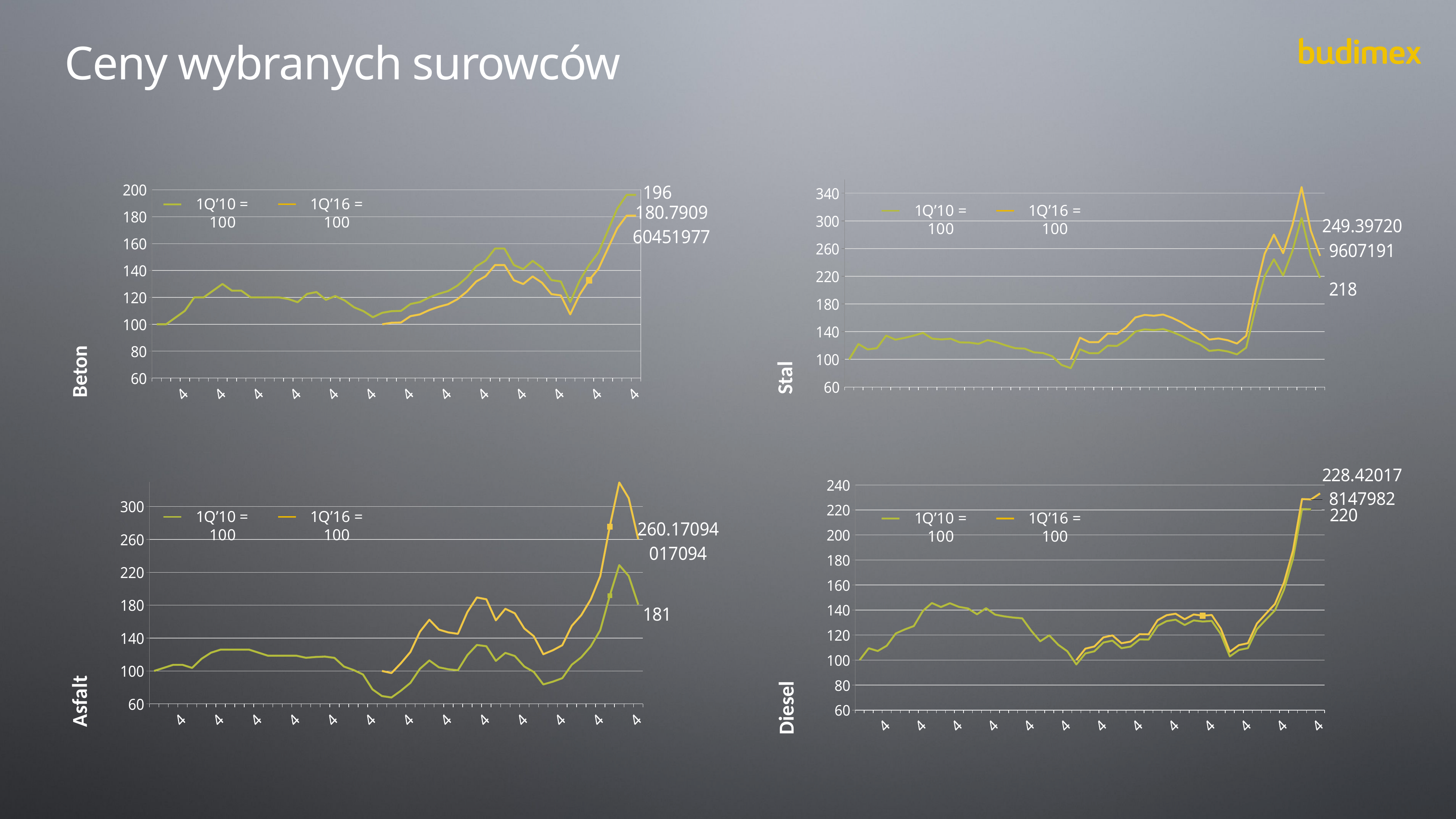
What is the title of the slide? Ceny wybranych surowców What is the difference between the final 1Q'10 = 100 value in the Beton chart (196) and in the Asfalt chart (181)? 15 In the Stal chart, what is the final labelled value of the 1Q'10 = 100 series? 218 How many charts are shown on the slide? 4 In the Asfalt chart, which series ends at a higher value, 1Q'10 = 100 or 1Q'16 = 100? 1Q'16 = 100 How many series does the legend of the Beton chart list? 2 What kind of chart is the Beton chart? line chart In the Beton chart, what is the final labelled value of the 1Q'10 = 100 series? 196 In the Diesel chart, do the values of the 1Q'10 = 100 series rise or fall over the last few quarters shown? rise In the Asfalt chart, is the peak value of the 1Q'16 = 100 series greater or less than 300? greater In the Asfalt chart, what is the final labelled value of the 1Q'10 = 100 series? 181 In the Diesel chart, what is the final labelled value of the 1Q'10 = 100 series? 220